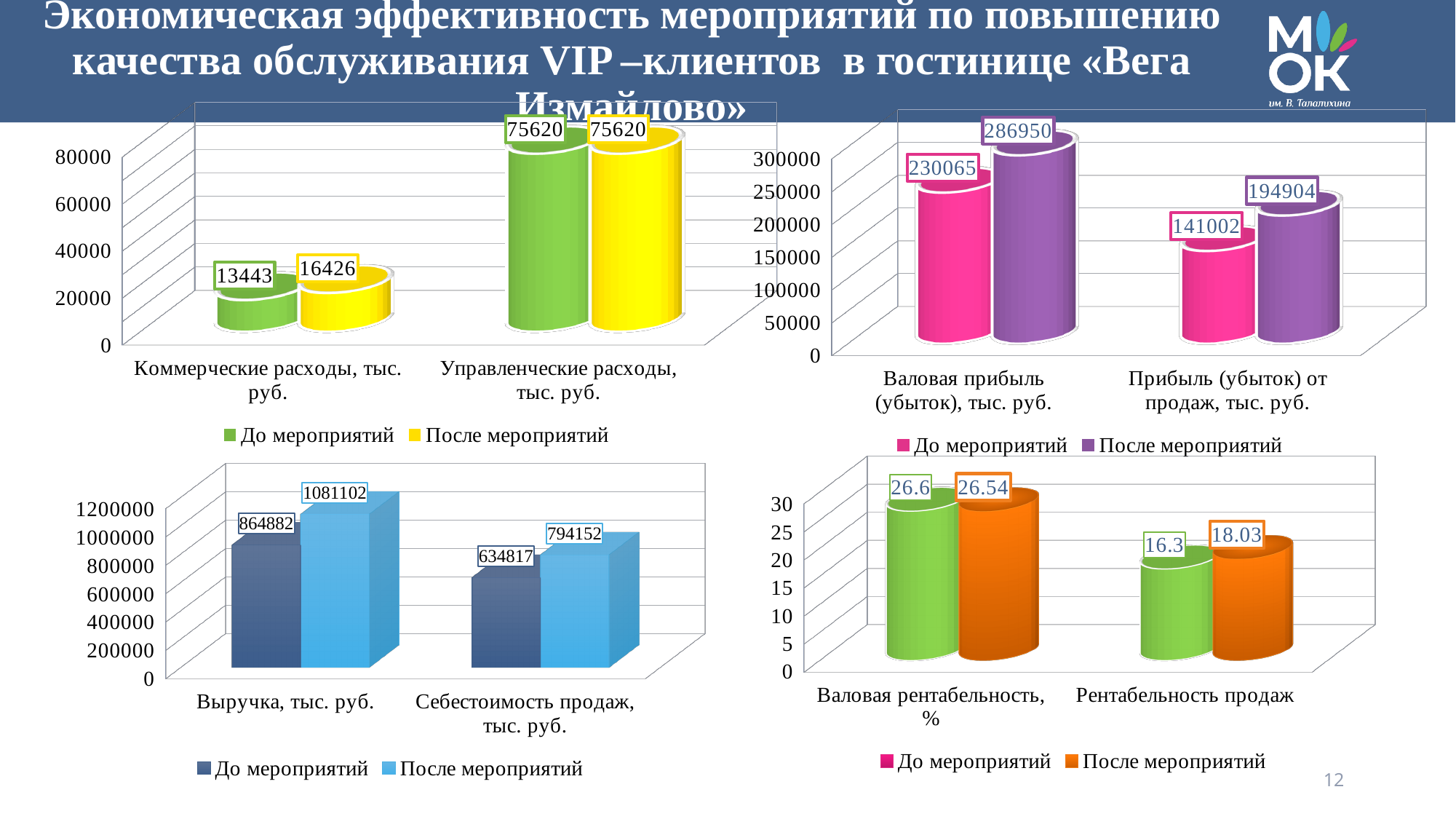
What kind of chart is the top-right chart? Bar chart In the bottom-left chart, what is the value of 'Выручка, тыс. руб.' for 'После мероприятий'? 1081102 In the bottom-right chart, what is the value of 'Рентабельность продаж' for 'После мероприятий'? 18.03 In the top-right chart, what is the value of 'Прибыль (убыток) от продаж, тыс. руб.' for 'До мероприятий'? 141002 In the bottom-left chart, what is the difference between the 'После мероприятий' and 'До мероприятий' values for 'Себестоимость продаж, тыс. руб.'? 159335 In the top-right chart, what is the value of 'Валовая прибыль (убыток), тыс. руб.' for 'После мероприятий'? 286950 In the top-left chart, what is the difference between the 'После мероприятий' and 'До мероприятий' values for 'Коммерческие расходы, тыс. руб.'? 2983 How many series does the legend of the bottom-left chart list? 2 In the top-right chart, which category has the lowest value for 'До мероприятий'? Прибыль (убыток) от продаж, тыс. руб. In the bottom-right chart, what is the value of 'Валовая рентабельность, %' for 'До мероприятий'? 26.6 In the top-left chart, what is the value of 'Коммерческие расходы, тыс. руб.' for 'После мероприятий'? 16426 In the top-left chart, what is the value of 'Коммерческие расходы, тыс. руб.' for 'До мероприятий'? 13443